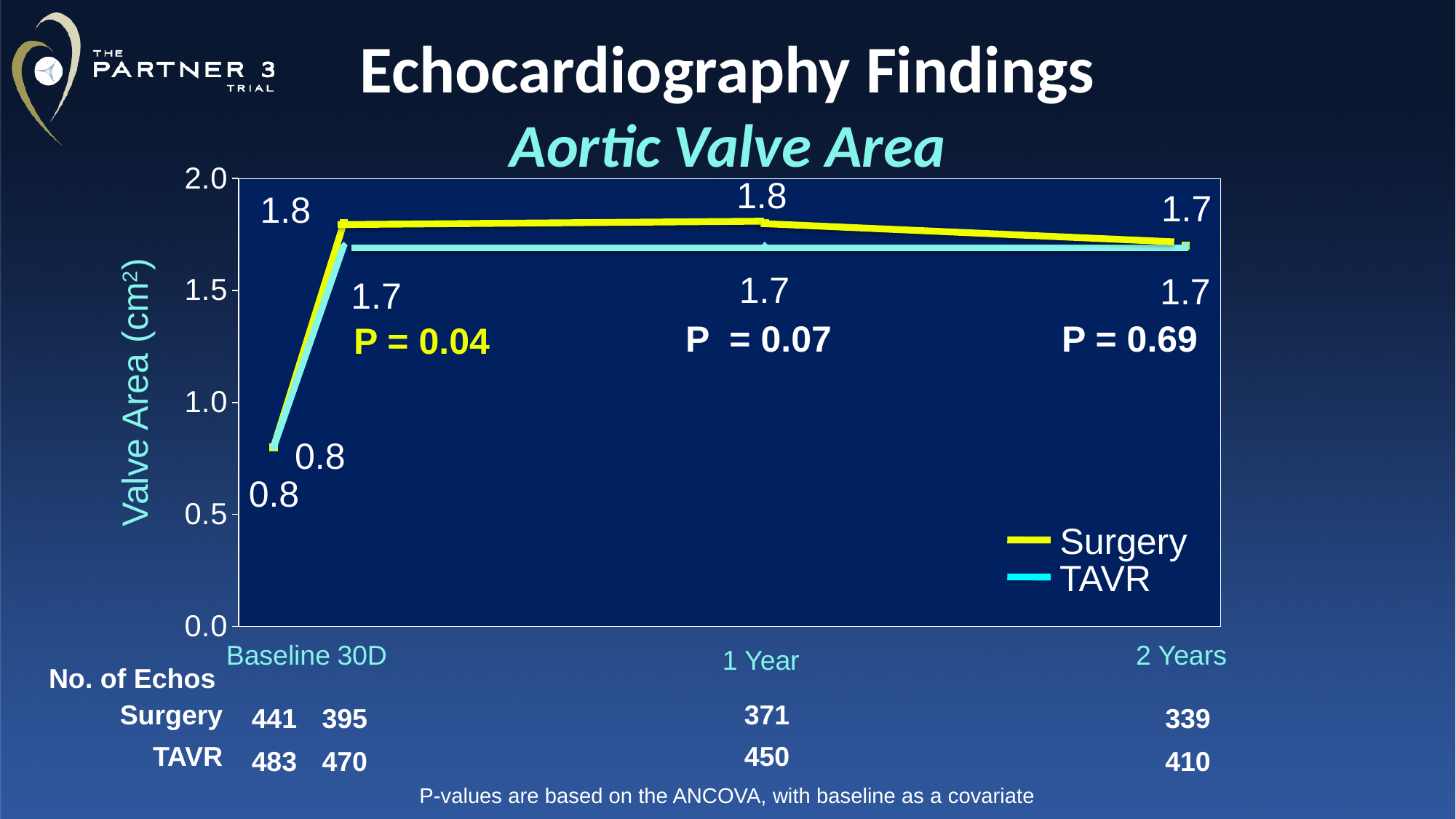
What is the difference between the Surgery and TAVR valve areas at 30D? 0.1 At which time point is the Surgery valve area lowest? Baseline How many time points are plotted along the x axis? 4 What is the baseline valve area for TAVR? 0.8 What is the valve area for TAVR at 1 Year? 1.7 What is the valve area for Surgery at 30D? 1.8 What is the P-value shown at 2 Years? P = 0.69 Does the TAVR valve area rise or fall from Baseline to 30D? rise Which series has the larger valve area at 1 Year, Surgery or TAVR? Surgery How many series does the legend list? 2 What type of chart is shown on the slide? line chart What is the valve area for Surgery at 2 Years? 1.7